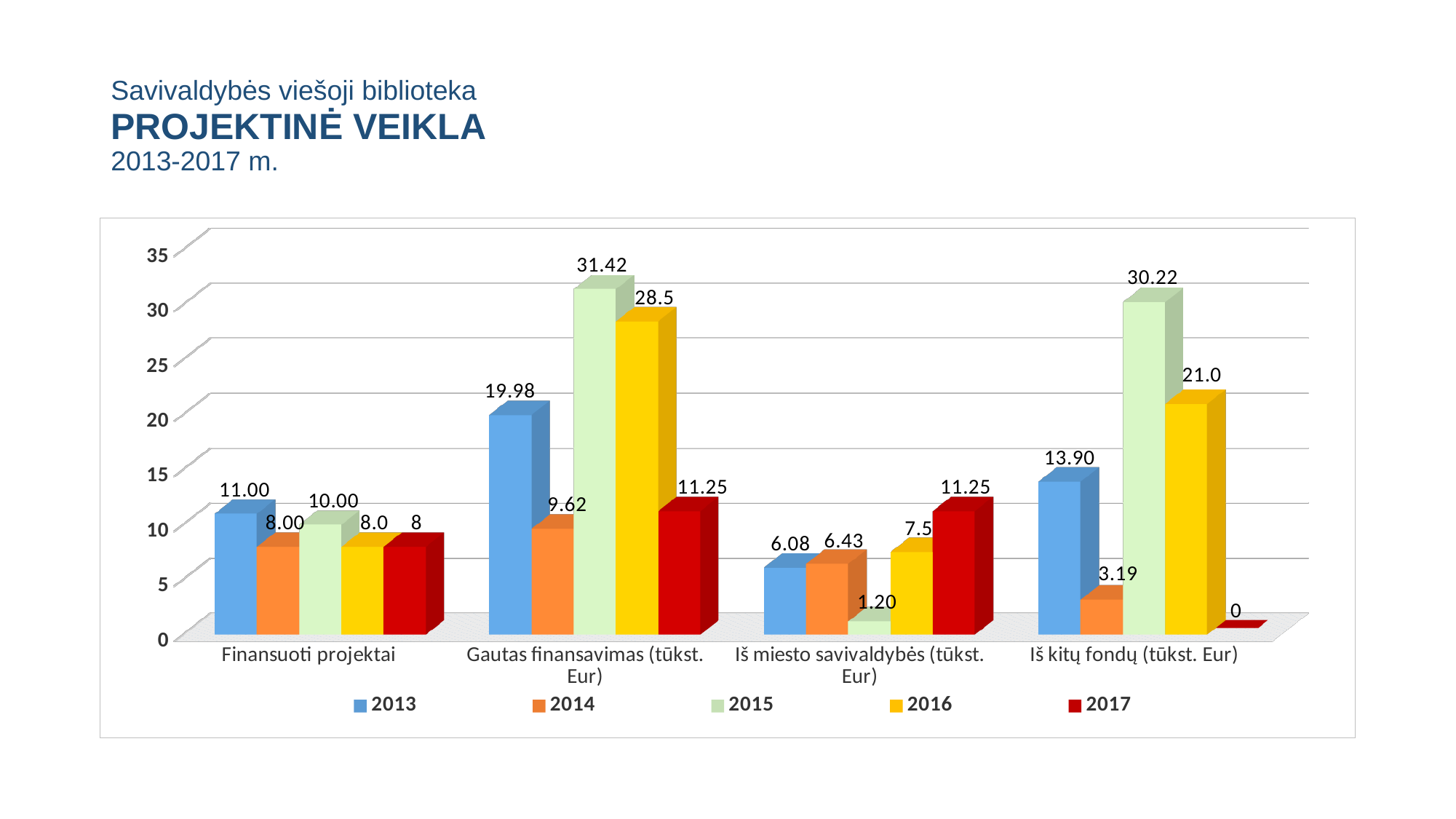
Which colour represents the 2017 series in the legend? Dark red Which year has the highest value in the Iš kitų fondų (tūkst. Eur) category? 2015 What is the value for 2013 in the Finansuoti projektai category? 11.00 What is the value for 2016 in the Iš miesto savivaldybės (tūkst. Eur) category? 7.5 Which year has the lowest value in the Iš miesto savivaldybės (tūkst. Eur) category? 2015 How many categories are shown on the x axis? 4 What is the value for 2017 in the Iš kitų fondų (tūkst. Eur) category? 0 What kind of chart is shown on the slide? Bar chart Which is larger in the Iš kitų fondų (tūkst. Eur) category: the value for 2013 or the value for 2016? 2016 What is the value for 2015 in the Gautas finansavimas (tūkst. Eur) category? 31.42 What is the difference between the 2015 and 2016 values in the Gautas finansavimas (tūkst. Eur) category? 2.92 How many series does the legend list? 5